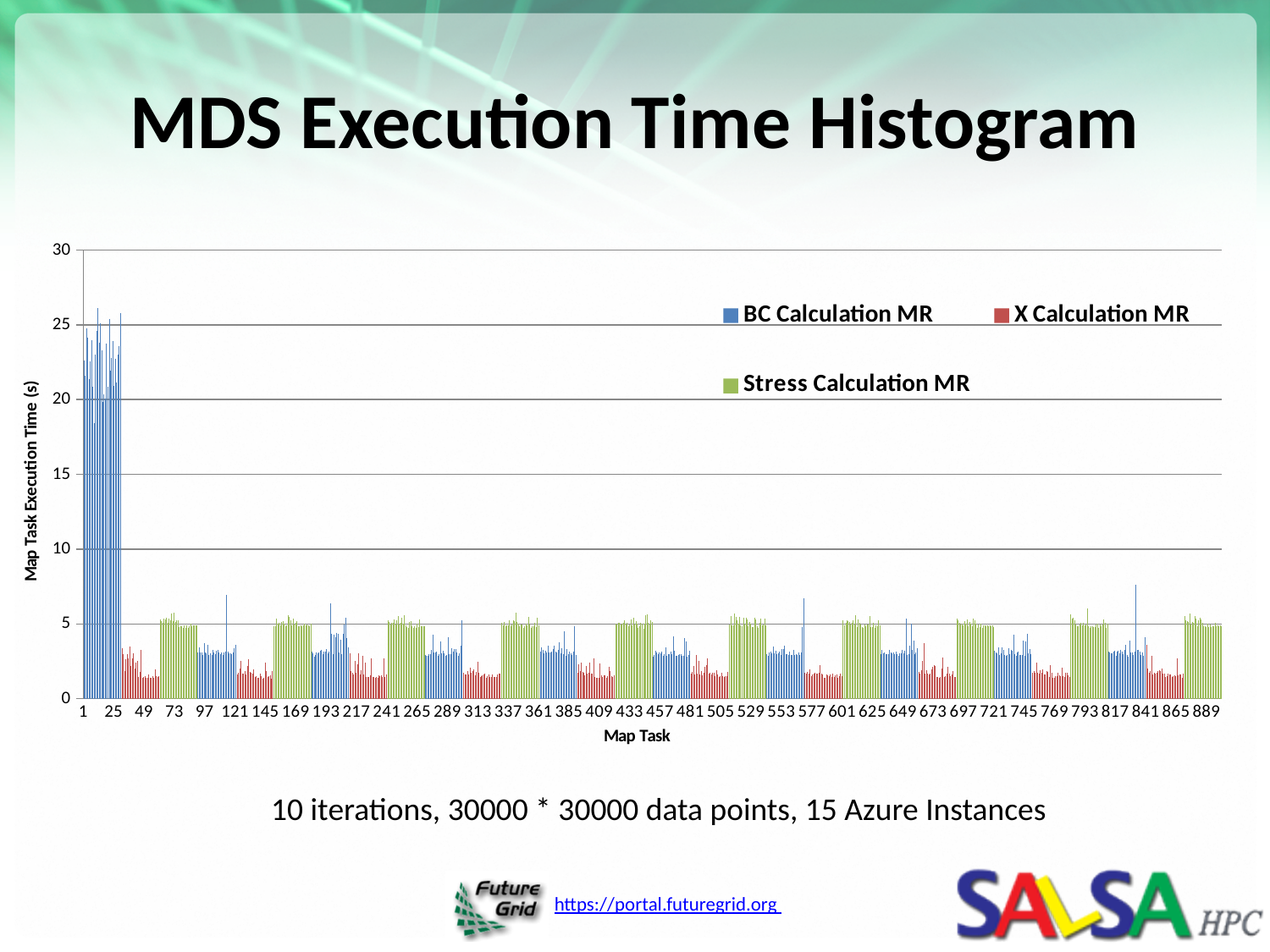
What is the title of the chart on the slide? MDS Execution Time Histogram What is the label of the vertical axis? Map Task Execution Time (s) What is the maximum value shown on the vertical axis? 30 Are the X Calculation MR values for map tasks around 49 greater or less than 5 seconds? less Around map task 49, which series has larger values: X Calculation MR or BC Calculation MR (around map task 1)? BC Calculation MR What kind of chart is shown on the slide? bar chart How many series does the chart legend list? 3 Are the Stress Calculation MR values for map tasks around 73 greater or less than 10 seconds? less Which series reaches the highest execution time in the chart? BC Calculation MR